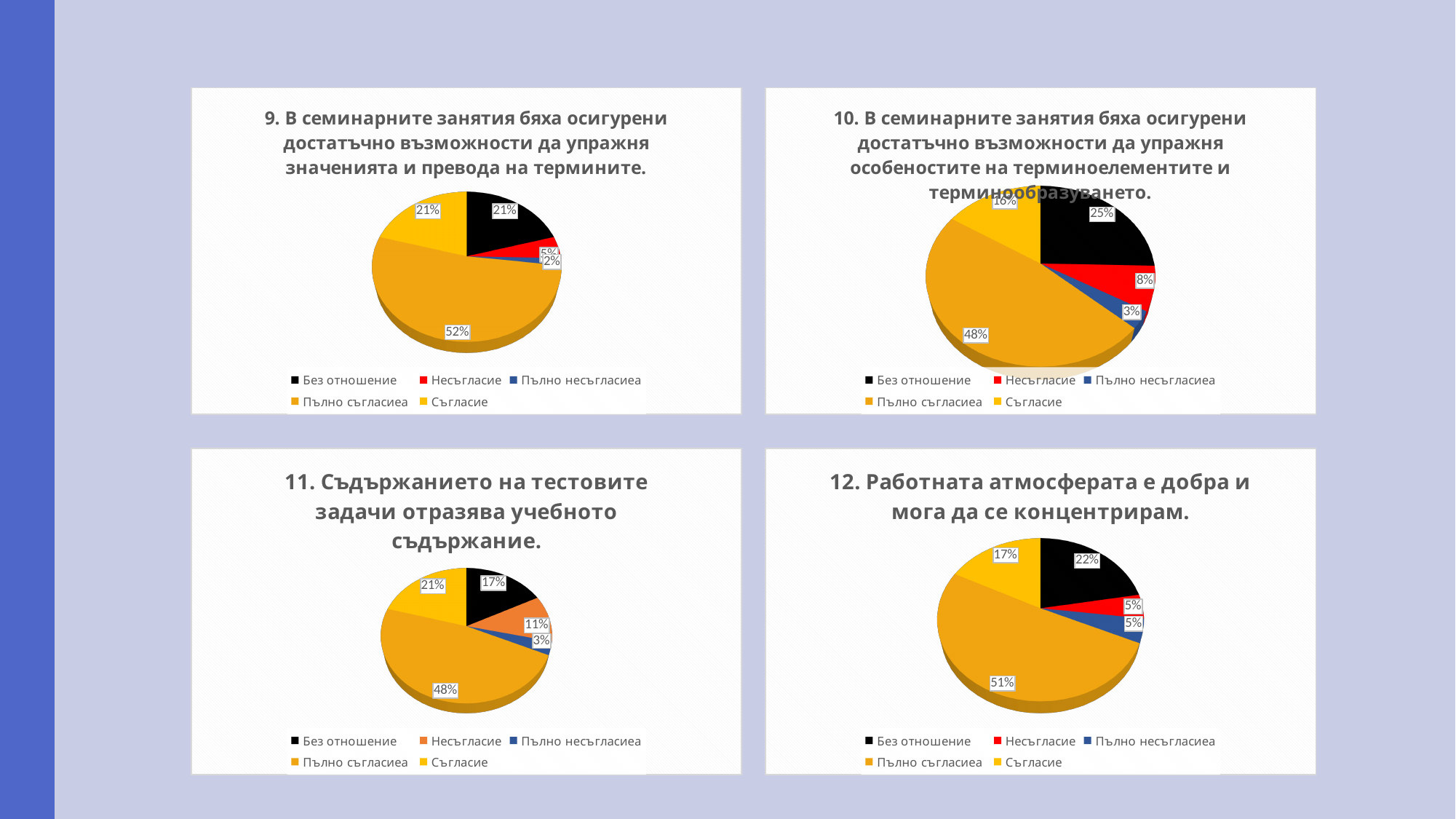
In the top-left chart (question 9), what share does the "Пълно съгласиеа" slice have? 52% In the top-left chart (question 9), what percentage is shown for "Несъгласие"? 5% How many charts are shown on the slide? 4 In the top-right chart (question 10), which category has the largest slice? Пълно съгласиеа What type of chart is used for question 11 (bottom-left)? Pie chart In the bottom-left chart (question 11), which category has the smallest slice? Пълно несъгласиеа In the bottom-left chart (question 11), what percentage is shown for "Несъгласие"? 11% In the top-left chart (question 9), which is larger: "Без отношение" or "Несъгласие"? Без отношение How many categories does the legend of the top-right chart (question 10) list? 5 In the top-right chart (question 10), what percentage is shown for "Без отношение"? 25% In the bottom-right chart (question 12), what percentage is shown for "Пълно съгласиеа"? 51% In the bottom-right chart (question 12), what is the difference between the "Без отношение" and "Съгласие" slices? 5%